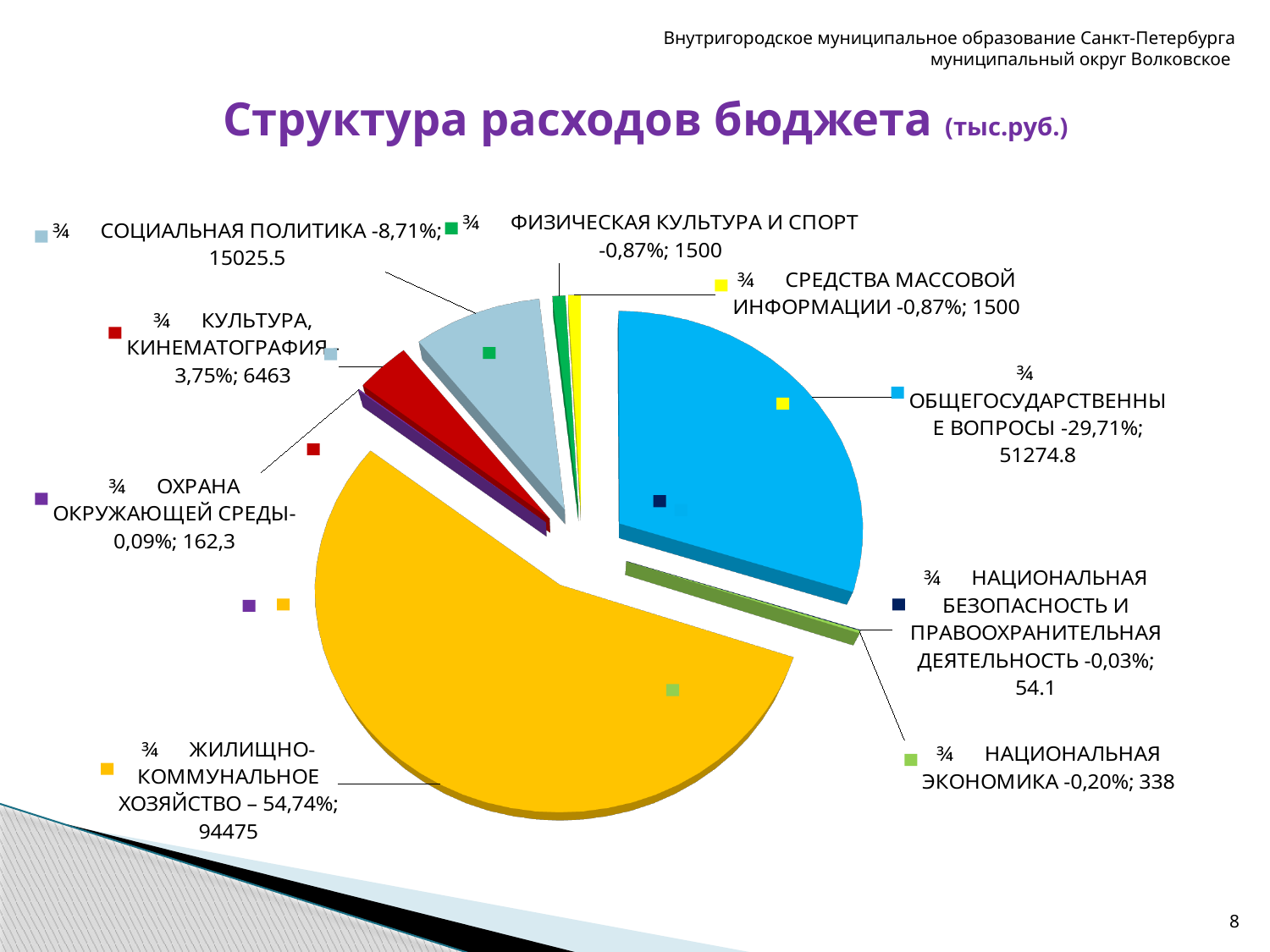
What is the value for СОЦИАЛЬНАЯ ПОЛИТИКА? 15025.5 What is the difference between the value for ЖИЛИЩНО-КОММУНАЛЬНОЕ ХОЗЯЙСТВО and the value for ОБЩЕГОСУДАРСТВЕННЫЕ ВОПРОСЫ? 43200.2 Which category has the largest share of the pie? ЖИЛИЩНО-КОММУНАЛЬНОЕ ХОЗЯЙСТВО Which category has the smallest share of the pie? НАЦИОНАЛЬНАЯ БЕЗОПАСНОСТЬ И ПРАВООХРАНИТЕЛЬНАЯ ДЕЯТЕЛЬНОСТЬ What kind of chart is shown on the slide? pie chart What is the title of the chart? Структура расходов бюджета (тыс.руб.) Which is larger, the value for НАЦИОНАЛЬНАЯ ЭКОНОМИКА or the value for ОХРАНА ОКРУЖАЮЩЕЙ СРЕДЫ? НАЦИОНАЛЬНАЯ ЭКОНОМИКА What is the value for ОБЩЕГОСУДАРСТВЕННЫЕ ВОПРОСЫ? 51274.8 How many categories does the pie chart show? 9 What share of the pie does ОБЩЕГОСУДАРСТВЕННЫЕ ВОПРОСЫ represent? 29,71% What share of the pie does КУЛЬТУРА, КИНЕМАТОГРАФИЯ represent? 3,75% What is the value for ЖИЛИЩНО-КОММУНАЛЬНОЕ ХОЗЯЙСТВО? 94475